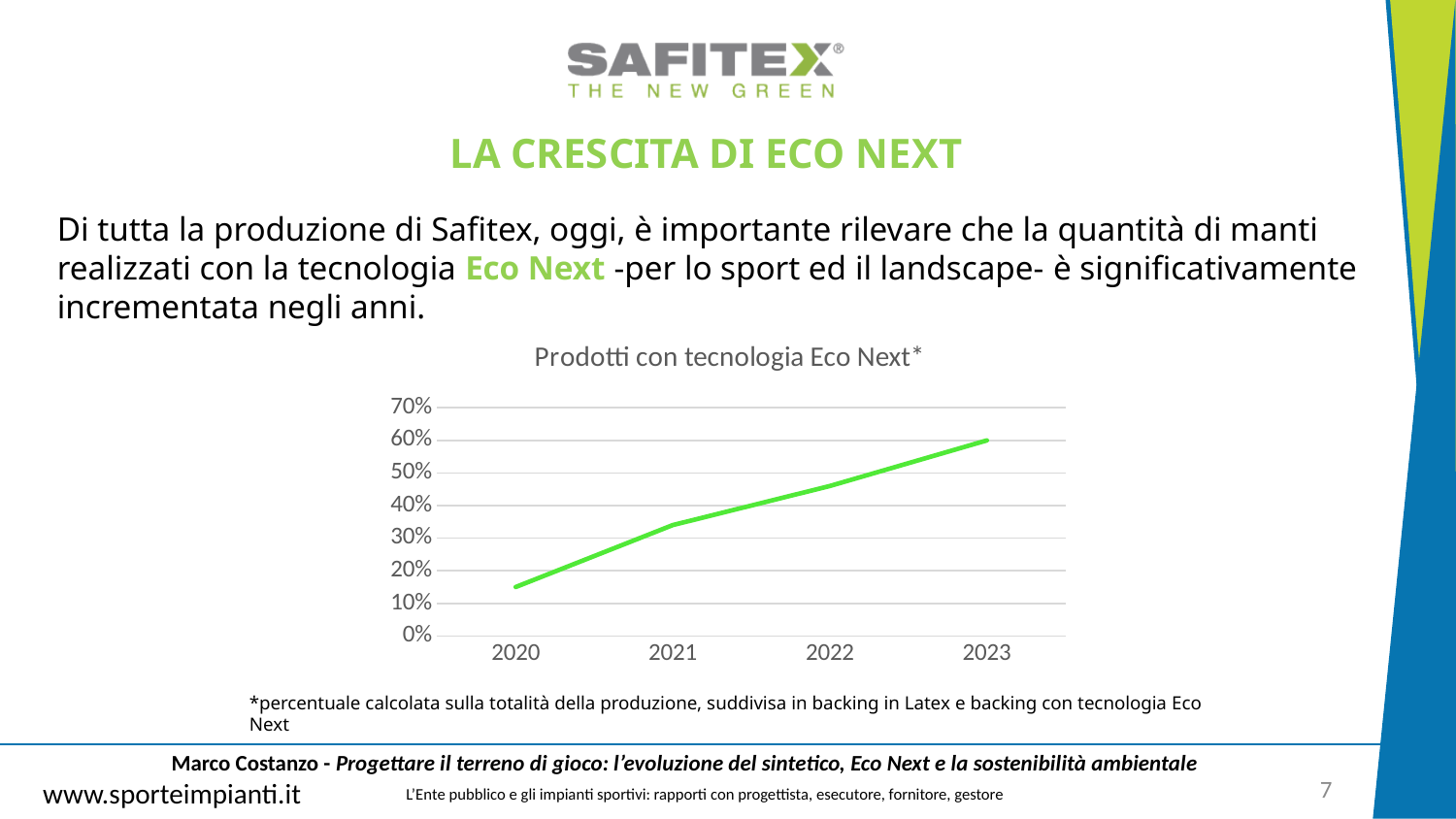
Which year has the larger value, 2021 or 2022? 2022 Is the value for 2020 greater or less than 20%? less Which year has the highest value in the chart? 2023 What is the title of the chart? Prodotti con tecnologia Eco Next* How many years are plotted on the x axis of the chart? 4 Is the value for 2023 greater or less than 50%? greater Is the value for 2022 greater or less than 40%? greater Which year has the lowest value in the chart? 2020 Do the values rise or fall from 2020 to 2023? rise What colour is the line in the chart? green What kind of chart is shown on the slide? line chart